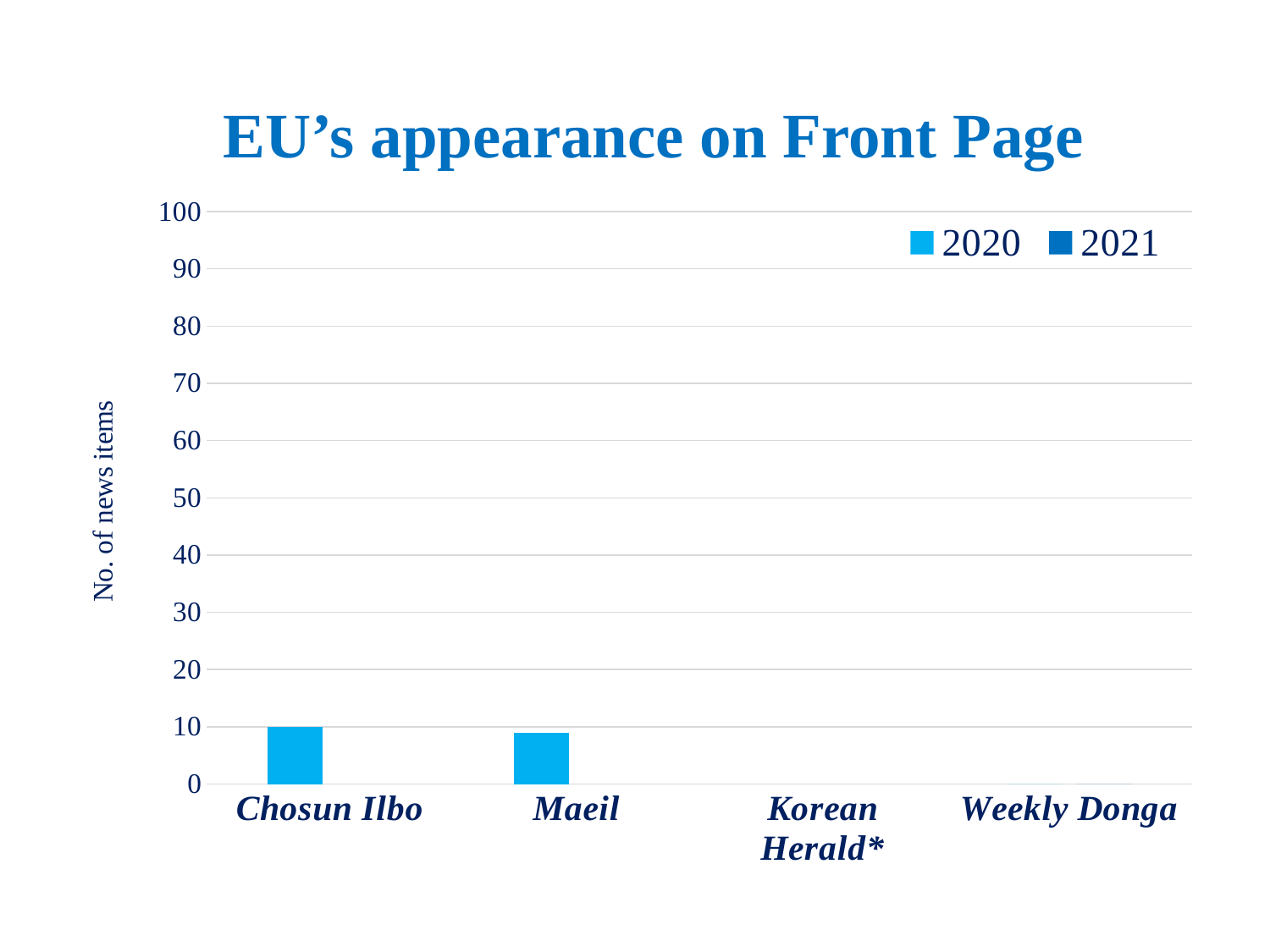
What is the title of the chart? EU's appearance on Front Page What is the highest value shown on the y axis? 100 What kind of chart is shown on the slide? bar chart Is the 2020 value for Maeil greater or less than 10? less Is the 2020 value for Chosun Ilbo greater or less than 20? less Which is larger, the 2020 value for Chosun Ilbo or the 2020 value for Maeil? Chosun Ilbo How many categories are shown on the x axis? 4 What is the label of the y axis? No. of news items How many series does the legend list? 2 Which category has the highest value for 2020? Chosun Ilbo Is the 2020 value for Maeil greater or less than 5? greater